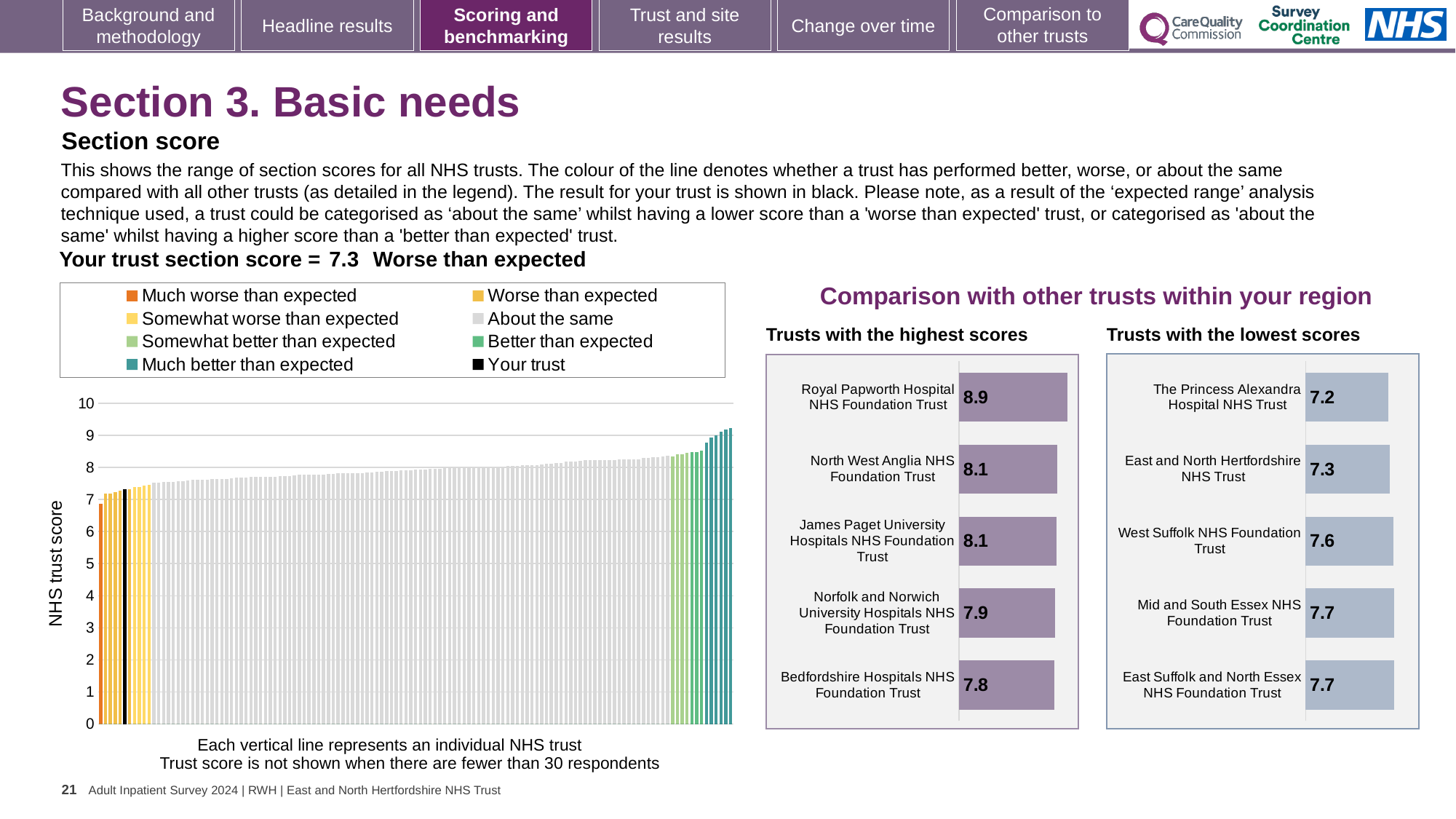
In the 'Trusts with the lowest scores' chart, what is the score for West Suffolk NHS Foundation Trust? 7.6 In the NHS trust score chart on the left, what is the section score for your trust (the black bar)? 7.3 In the 'Trusts with the highest scores' chart, what is the difference between the scores of Royal Papworth Hospital NHS Foundation Trust and Norfolk and Norwich University Hospitals NHS Foundation Trust? 1.0 In the 'Trusts with the highest scores' chart, what is the score for Royal Papworth Hospital NHS Foundation Trust? 8.9 How many entries does the legend of the NHS trust score chart on the left list? 8 In the 'Trusts with the lowest scores' chart, which has the higher score: East and North Hertfordshire NHS Trust or Mid and South Essex NHS Foundation Trust? Mid and South Essex NHS Foundation Trust In the 'Trusts with the lowest scores' chart, which trust has the lowest score? The Princess Alexandra Hospital NHS Trust In the 'Trusts with the lowest scores' chart, how many trusts are shown? 5 In the NHS trust score chart on the left, do the values rise or fall from left to right? rise In the 'Trusts with the lowest scores' chart, what is the difference between the scores of East Suffolk and North Essex NHS Foundation Trust and The Princess Alexandra Hospital NHS Trust? 0.5 In the 'Trusts with the highest scores' chart, which trust has the highest score? Royal Papworth Hospital NHS Foundation Trust In the 'Trusts with the highest scores' chart, what is the score for Bedfordshire Hospitals NHS Foundation Trust? 7.8